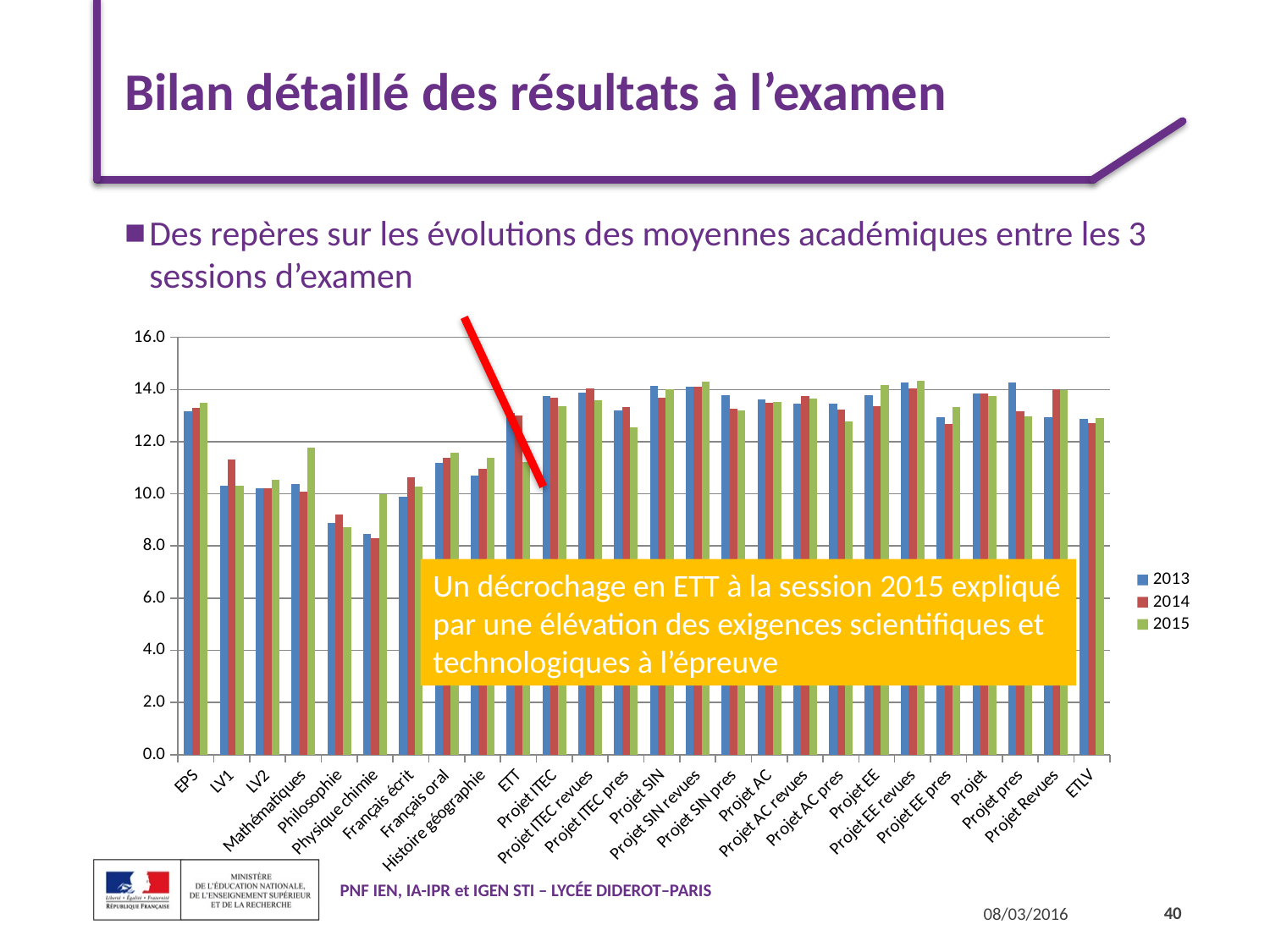
Is the 2013 value for Physique chimie greater or less than 10? less How many categories are shown along the x axis of the chart? 26 How many series does the legend list? 3 Is the 2013 value for Philosophie greater or less than 10? less Do the values for ETT rise or fall from 2013 to 2015? fall Which is larger for 2013: Mathématiques or Philosophie? Mathématiques Which category has the lowest 2014 value? Physique chimie Which is larger for ETT: the 2013 value or the 2015 value? 2013 Is the 2015 value for Mathématiques greater or less than 10? greater Which years are listed in the chart legend? 2013, 2014, 2015 What kind of chart is shown on the slide? bar chart